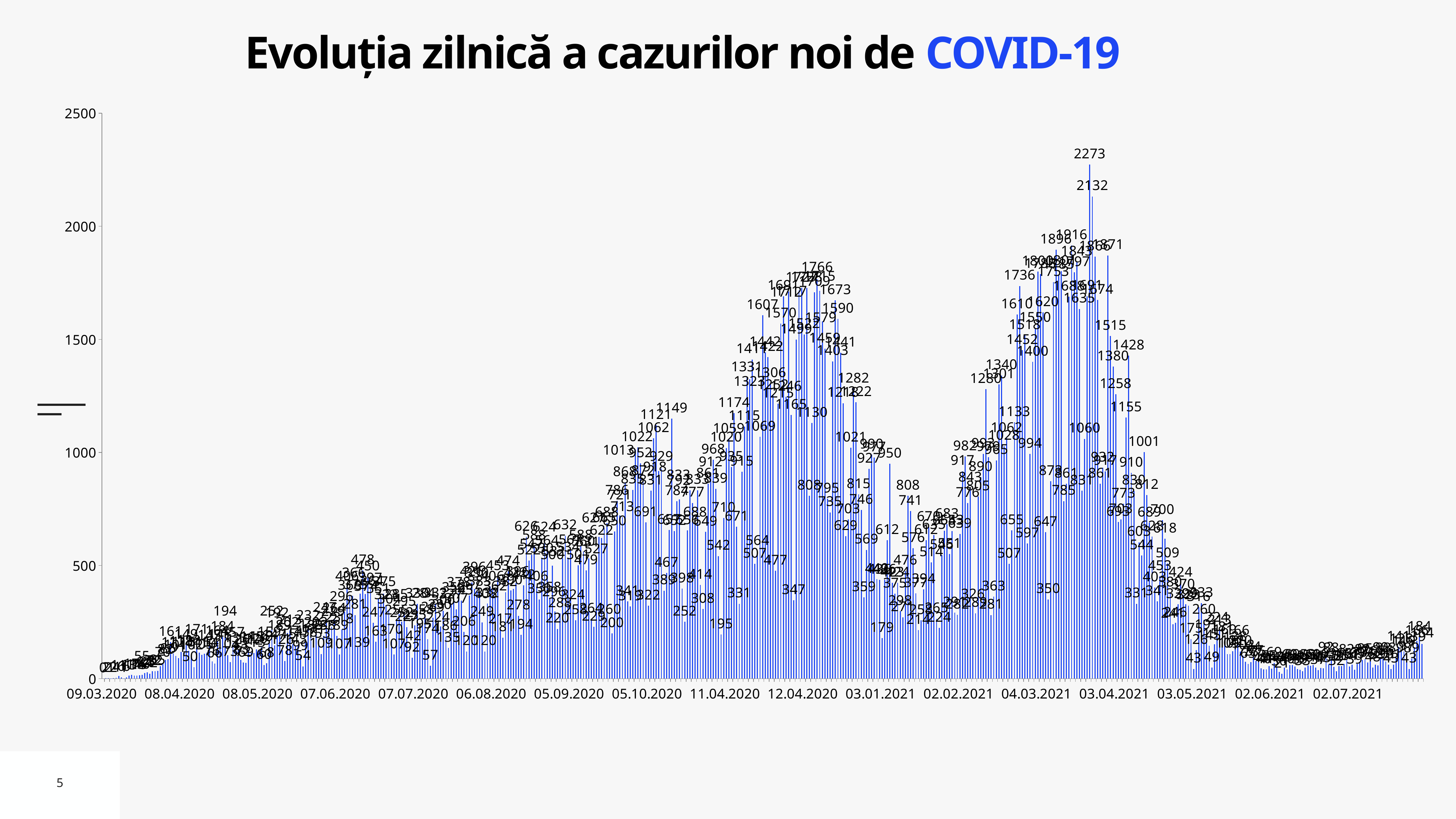
What is the first date label on the horizontal axis? 09.03.2020 What is the maximum value shown on the vertical axis? 2500 What is the second-highest value labelled on the chart, next to the 2273 peak? 2132 What is the title of the chart? Evoluția zilnică a cazurilor noi de COVID-19 What kind of chart is shown on the slide? bar chart Between 03.04.2021 and 02.06.2021, do the values generally rise or fall? fall What is the difference between the two highest labelled values, 2273 and 2132? 141 What is the highest daily value labelled on the chart? 2273 Is the highest value on the chart greater or less than 2000? greater What is the highest value labelled in the peak around 12.04.2020? 1766 Are the values around 02.06.2021 greater or less than 500? less Which peak is higher: the one around 12.04.2020 or the one around 03.04.2021? the one around 03.04.2021